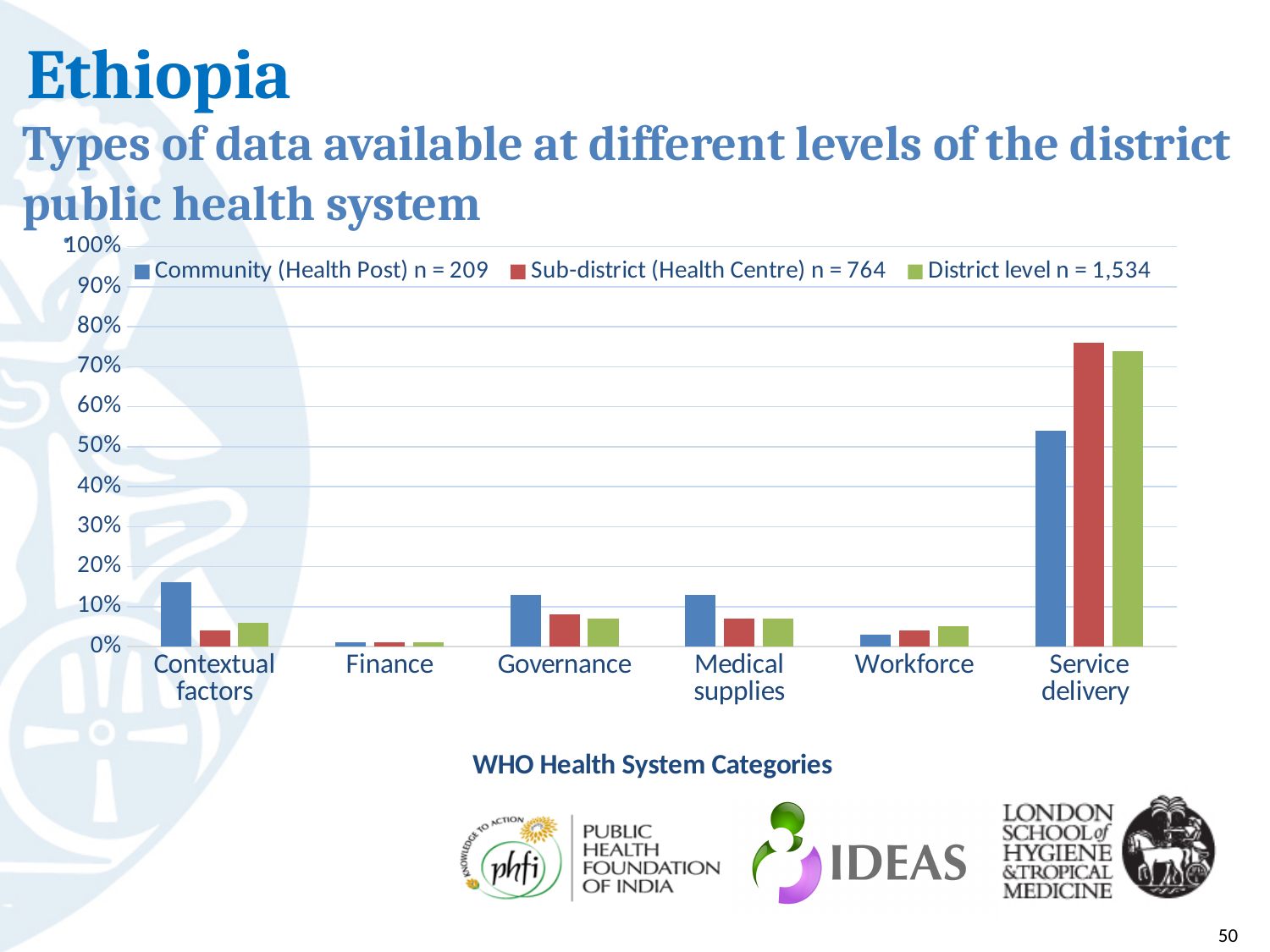
Is the Sub-district (Health Centre) value for Service delivery greater or less than 70%? greater What sample size (n) does the legend give for the District level series? 1,534 For Contextual factors, which is larger: the Community (Health Post) value or the Sub-district (Health Centre) value? Community (Health Post) What kind of chart is shown on the slide? bar chart How many WHO Health System Categories are shown on the x axis? 6 How many series does the legend list? 3 Is the Community (Health Post) value for Service delivery greater or less than 50%? greater Which category has the lowest value for the Community (Health Post) series? Finance What is the title of the x axis? WHO Health System Categories For Service delivery, which is larger: the Community (Health Post) value or the District level value? District level Which category has the highest value for the District level series? Service delivery Is the Community (Health Post) value for Contextual factors greater or less than 10%? greater